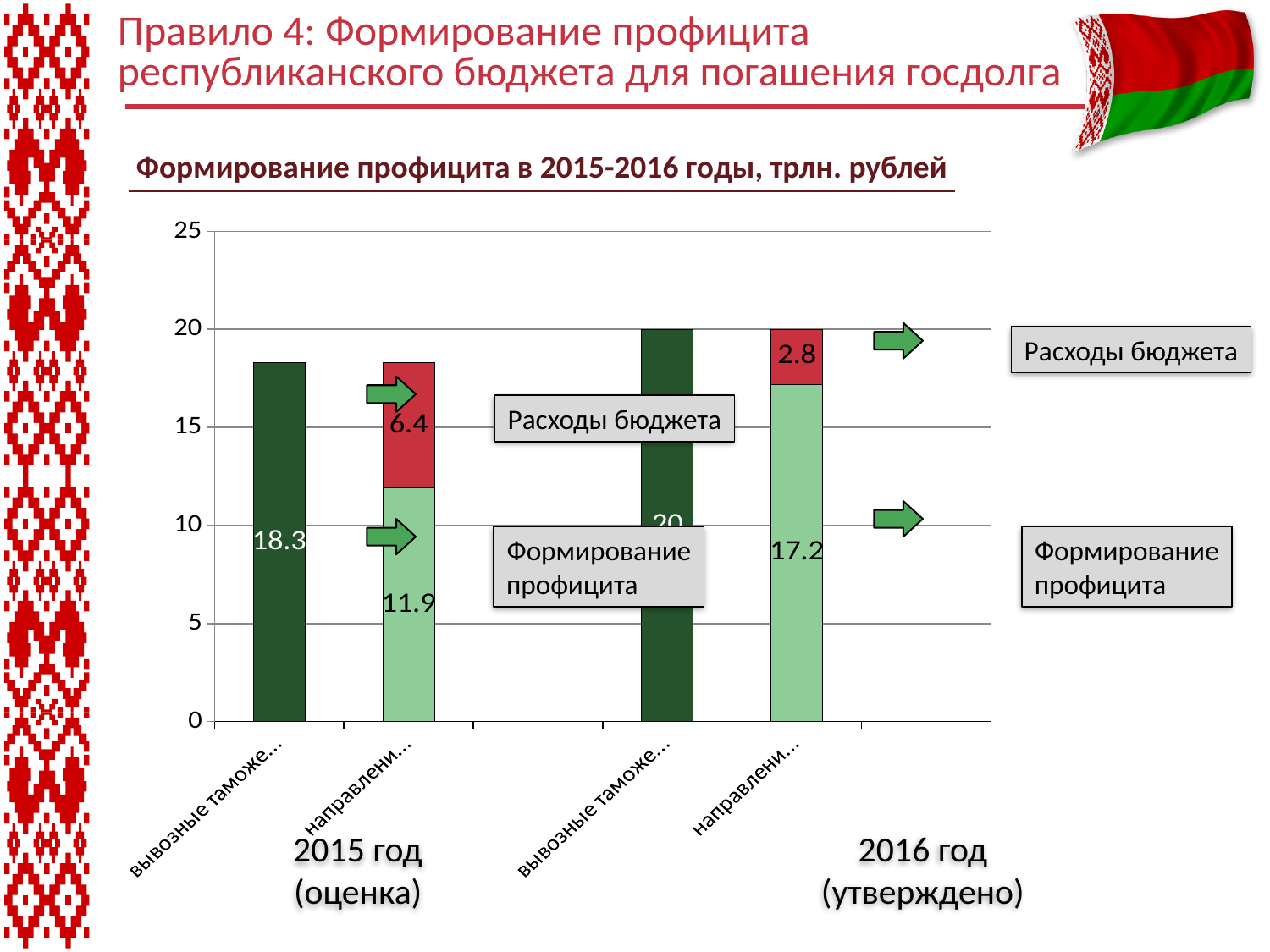
In the stacked bar for 2015 год (оценка), what is the value of the red segment labelled Расходы бюджета? 6.4 What is the total of the stacked bar for 2015 год (оценка)? 18.3 Which is larger: the Расходы бюджета segment in 2015 or in 2016? 2015 In the stacked bar for 2016 год (утверждено), what is the value of the red segment labelled Расходы бюджета? 2.8 What is the value of the dark green bar for 2015 год (оценка)? 18.3 What is the difference between the Формирование профицита values for 2016 (17.2) and 2015 (11.9)? 5.3 What type of chart is shown on the slide? bar chart In the stacked bar for 2015 год (оценка), what is the value of the light green segment labelled Формирование профицита? 11.9 What is the total of the stacked bar for 2016 год (утверждено)? 20 What is the value of the dark green bar for 2016 год (утверждено)? 20 What is the title of the chart? Формирование профицита в 2015-2016 годы, трлн. рублей In the stacked bar for 2016 год (утверждено), what is the value of the light green segment labelled Формирование профицита? 17.2